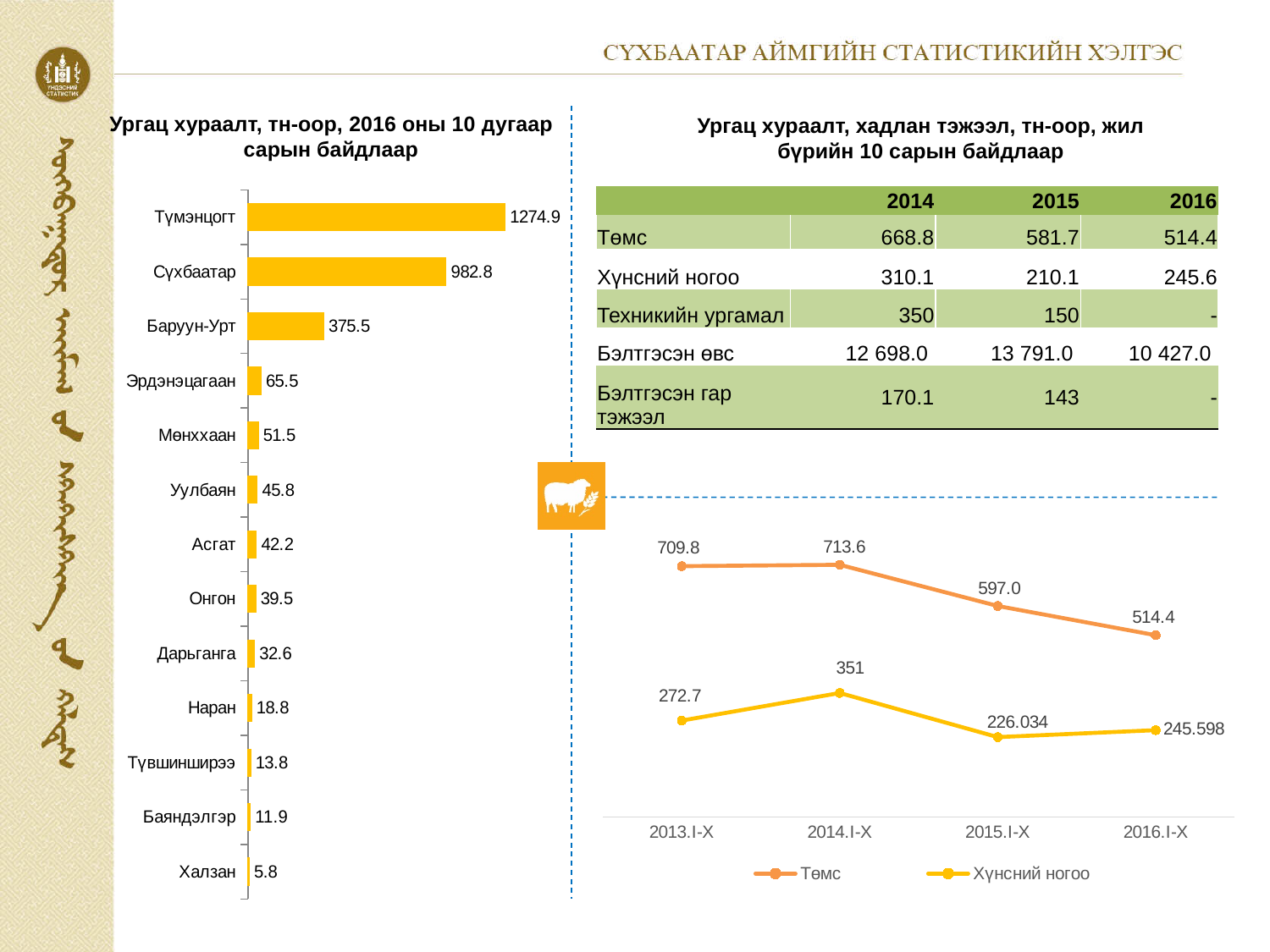
In the line chart on the right, which is larger at 2013.I-X: Төмс or Хүнсний ногоо? Төмс In the bar chart on the left, which category has the highest value? Түмэнцогт In the line chart on the right, what is the value for Төмс at 2014.I-X? 713.6 In the line chart on the right, what is the value for Хүнсний ногоо at 2015.I-X? 226.034 In the bar chart on the left, which category has the lowest value? Халзан In the bar chart on the left, what is the value for Түмэнцогт? 1274.9 In the bar chart on the left, what is the difference between the values for Түмэнцогт and Сүхбаатар? 292.1 In the bar chart on the left, how many categories are shown? 13 In the line chart on the right, does the Төмс series rise or fall from 2014.I-X to 2016.I-X? Fall In the line chart on the right, how many series does the legend list? 2 In the bar chart on the left, what is the value for Баруун-Урт? 375.5 What kind of chart is the chart on the left of the slide? Bar chart